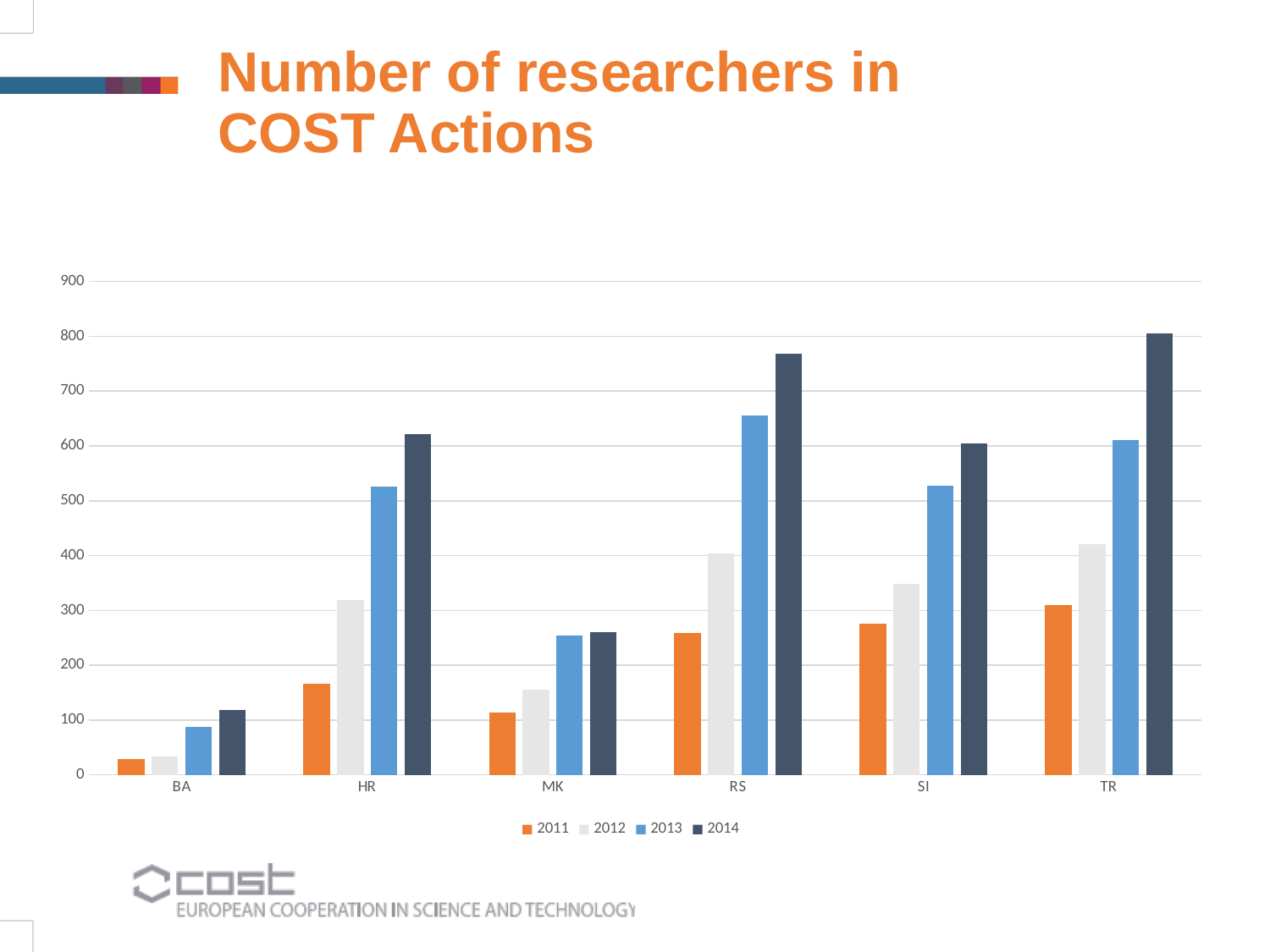
Is the value for TR in 2014 greater or less than 700? greater Which years are listed in the legend? 2011, 2012, 2013, 2014 Which country has the highest value for 2014? TR Which is larger, the 2013 value for RS or the 2013 value for SI? RS Is the value for BA in 2013 greater or less than 100? less How many countries are shown on the x axis? 6 For RS, do the values rise or fall from 2011 to 2014? rise Which country has the lowest value for 2014? BA What kind of chart is shown on the slide? bar chart How many series does the legend list? 4 What is the title of the slide? Number of researchers in COST Actions Is the value for HR in 2012 greater or less than 400? less